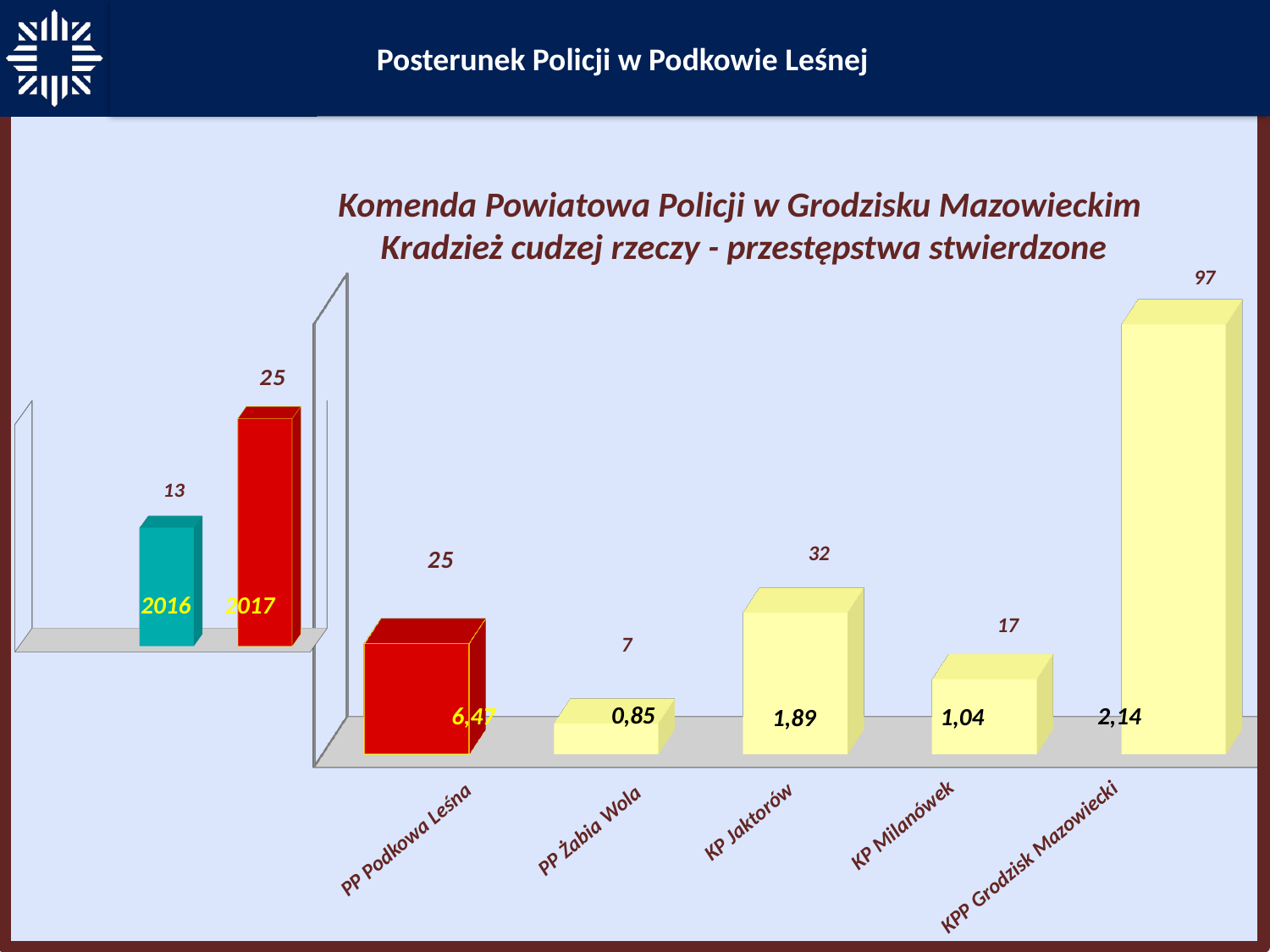
In the main chart, what is the value for KP Jaktorów? 32 In the main chart, which category has the highest value? KPP Grodzisk Mazowiecki How many categories are shown in the main chart? 5 In the main chart, which is larger: the value for KP Milanówek or the value for PP Podkowa Leśna? PP Podkowa Leśna In the main chart, what is the value for KPP Grodzisk Mazowiecki? 97 In the main chart, which category has the lowest value? PP Żabia Wola What kind of chart is the main chart on the slide? bar chart In the small chart on the left, what is the difference between the 2017 and 2016 values? 12 In the main chart, what is the lower label printed at the base of the KP Milanówek bar? 1,04 In the main chart, what is the value for PP Żabia Wola? 7 In the main chart, what is the difference between the values for KPP Grodzisk Mazowiecki and KP Jaktorów? 65 In the small chart on the left, what is the value for 2017? 25